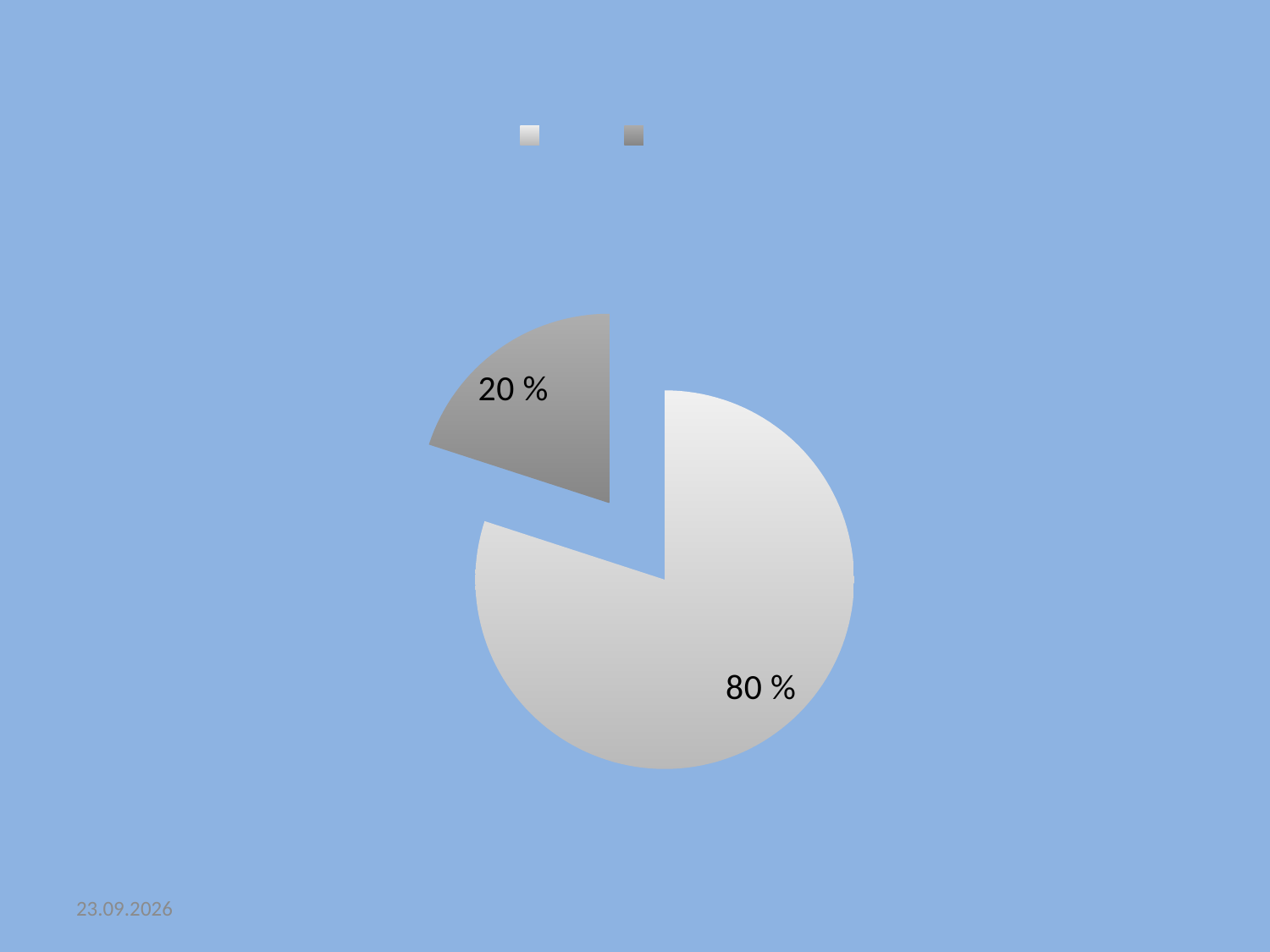
What is the value of the smallest slice in the pie chart? 20 % What share of the pie does the dark grey slice represent? 20 % What value is labelled on the light grey slice of the pie chart? 80 % Which slice of the pie chart is pulled out from the rest of the pie? the dark grey 20 % slice What is the value of the largest slice in the pie chart? 80 % Which slice of the pie chart is larger, the light grey one or the dark grey one? the light grey one What is the difference between the two slices of the pie chart? 60 % How many entries does the legend of the pie chart list? 2 What value is labelled on the dark grey slice of the pie chart? 20 % How many slices does the pie chart have? 2 What kind of chart is shown on the slide? pie chart